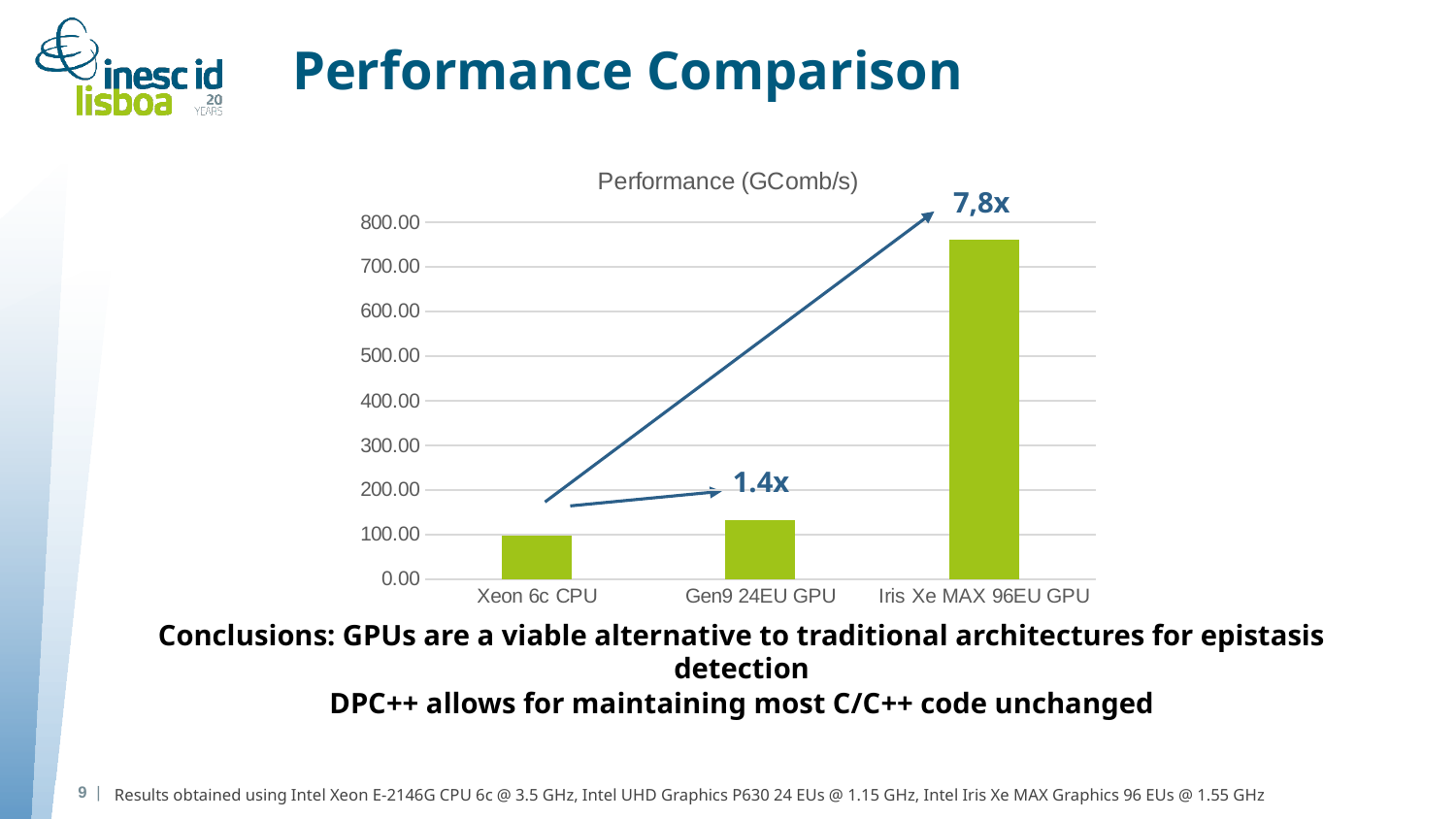
Is the value for Gen9 24EU GPU greater or less than 100.00? greater What speedup factor is annotated on the arrow pointing to the Iris Xe MAX 96EU GPU bar? 7,8x Which category has the lowest value in the chart? Xeon 6c CPU Is the value for Xeon 6c CPU greater or less than 200.00? less What is the title of the chart? Performance (GComb/s) How many categories are plotted on the x axis of the chart? 3 Is the value for Iris Xe MAX 96EU GPU greater or less than 700.00? greater What is the highest value shown on the y axis of the chart? 800.00 Which category has the highest value in the chart? Iris Xe MAX 96EU GPU Which has a larger value, Gen9 24EU GPU or Iris Xe MAX 96EU GPU? Iris Xe MAX 96EU GPU What kind of chart is shown on the slide? bar chart Do the values rise or fall from left to right along the x axis? rise